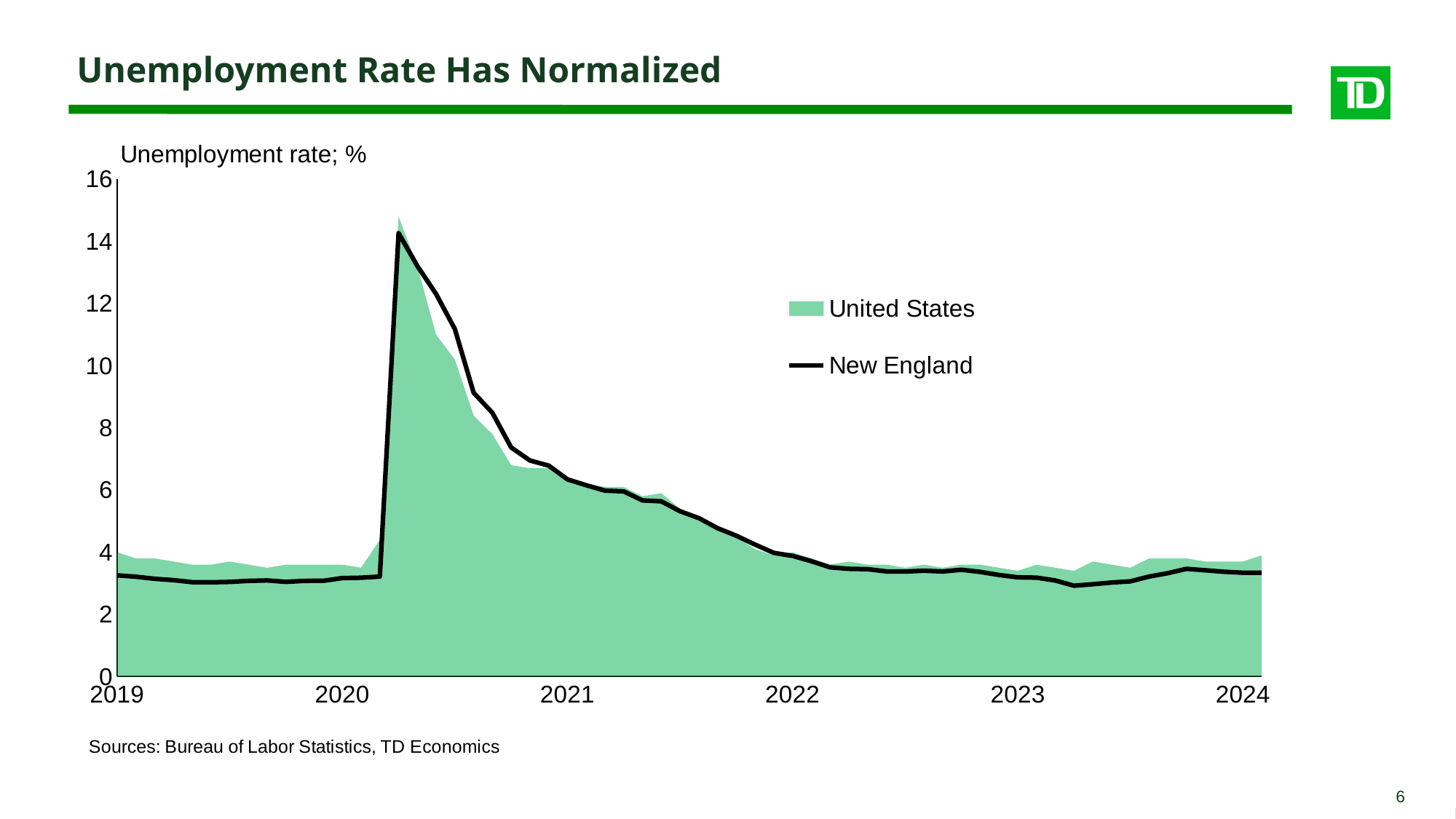
How many series does the legend list? 2 At the start of 2019, which series has the higher unemployment rate, United States or New England? United States What is the highest value shown on the y axis? 16 What is the title of the slide? Unemployment Rate Has Normalized Is the peak value for New England in 2020 greater or less than 12? greater Is the peak value for United States in 2020 greater or less than 14? greater In which year does the unemployment rate reach its highest point for both series? 2020 What are the two series named in the legend? United States and New England What kind of chart is shown on the slide? Area chart with a line overlay From the 2020 peak through 2022, does the unemployment rate rise or fall? Fall Is the value for United States at the start of 2024 greater or less than 6? less